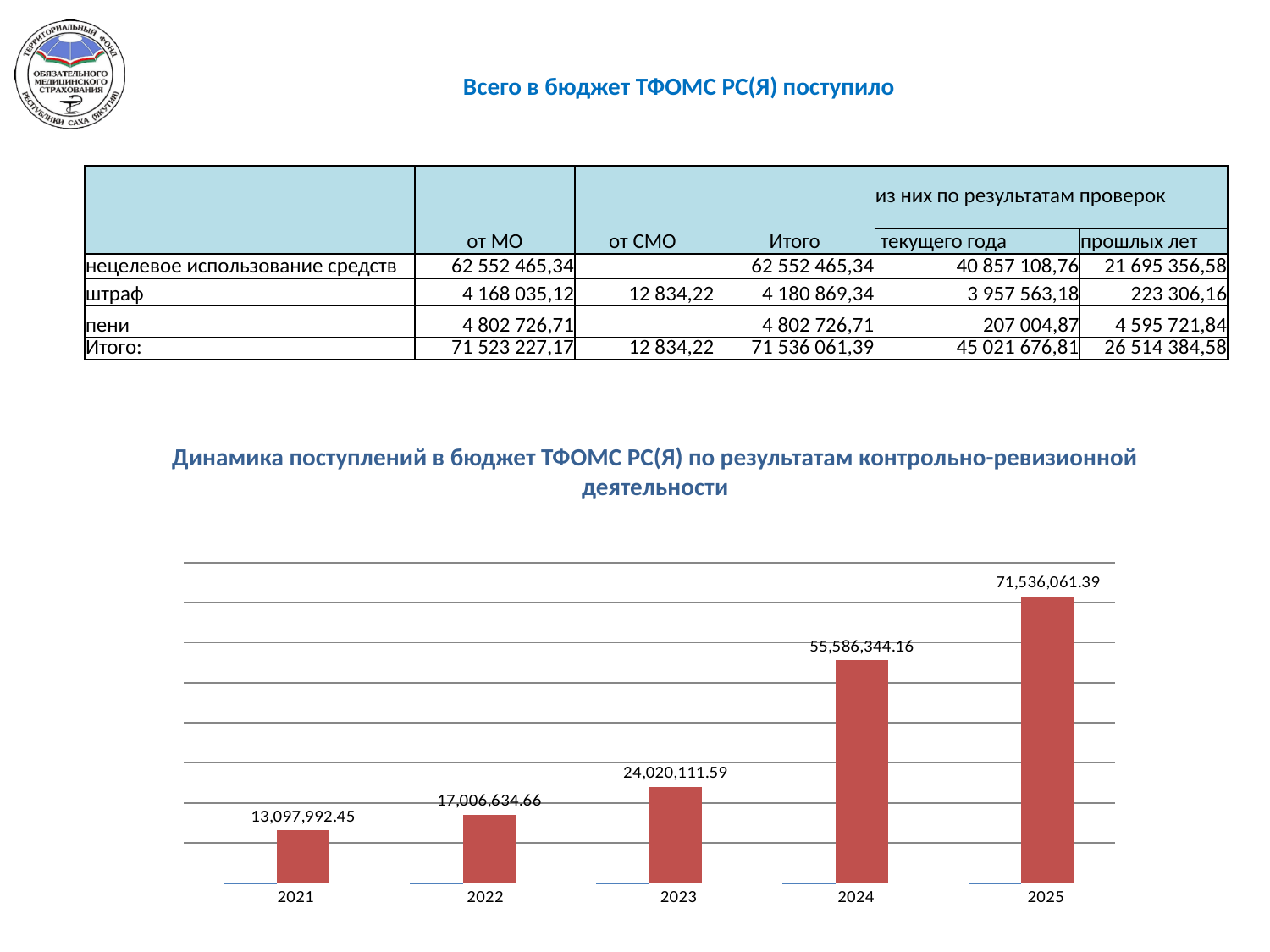
What is the value for 2025 in the chart? 71,536,061.39 Which year has the highest value in the chart? 2025 What is the difference between the values for 2025 and 2024 in the chart? 15,949,717.23 How many years are shown on the x axis of the chart? 5 What is the value for 2023 in the chart? 24,020,111.59 What is the value for 2021 in the chart? 13,097,992.45 Which is larger in the chart, the value for 2023 or the value for 2024? 2024 What type of chart is shown on the slide? bar chart What is the value for 2022 in the chart? 17,006,634.66 Which year has the lowest value in the chart? 2021 What is the title of the chart? Динамика поступлений в бюджет ТФОМС РС(Я) по результатам контрольно-ревизионной деятельности Do the values in the chart rise or fall from 2021 to 2025? rise